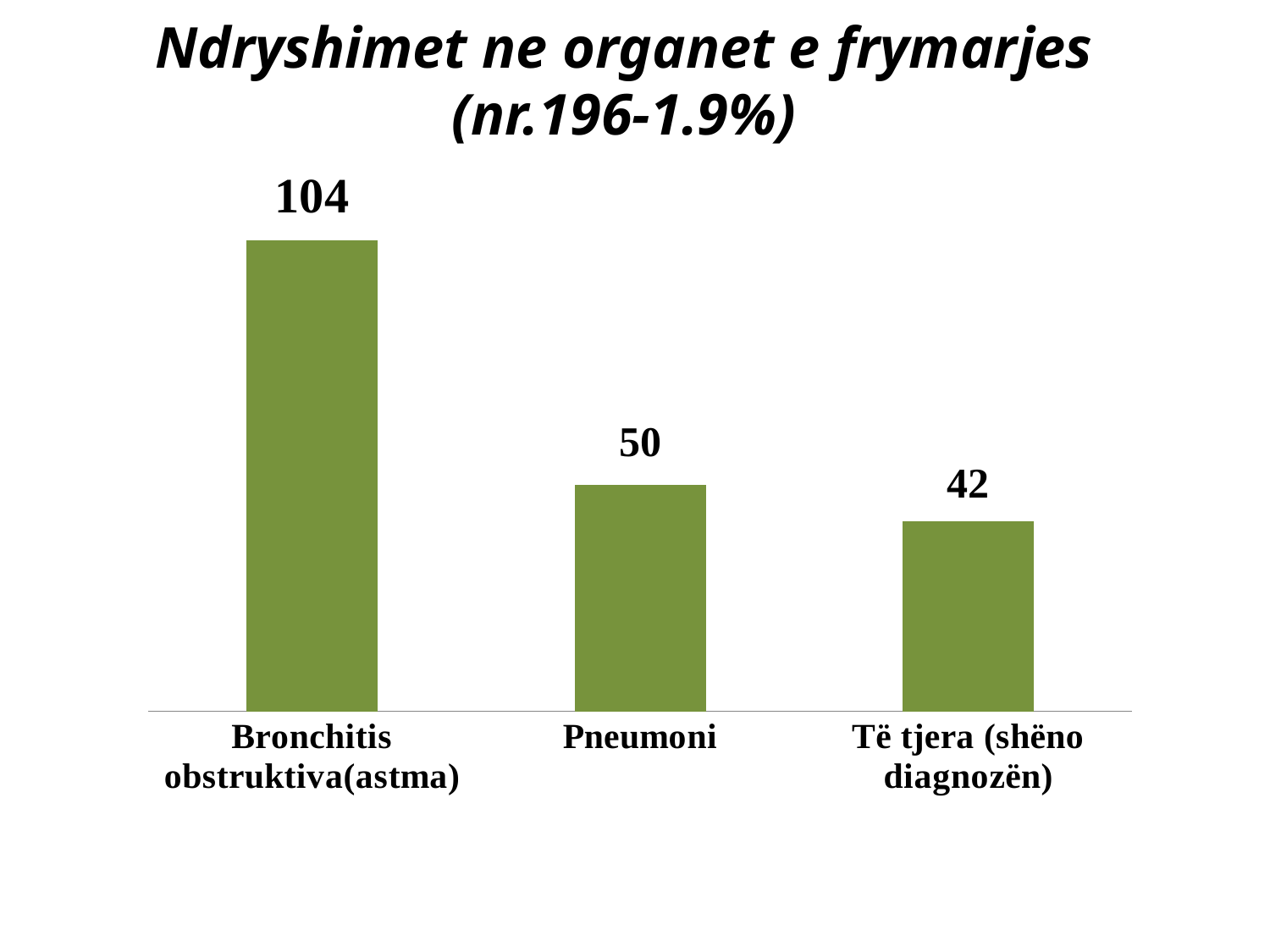
What is the difference between the values for Bronchitis obstruktiva(astma) and Pneumoni? 54 Which category has the lowest value? Të tjera (shëno diagnozën) What kind of chart is shown on the slide? Bar chart Do the values rise or fall from left to right across the categories? Fall What is the value for Bronchitis obstruktiva(astma)? 104 Which is larger, the value for Pneumoni or the value for Të tjera (shëno diagnozën)? Pneumoni What is the title of the slide? Ndryshimet ne organet e frymarjes (nr.196-1.9%) Which category has the highest value? Bronchitis obstruktiva(astma) What is the value for Të tjera (shëno diagnozën)? 42 What is the value for Pneumoni? 50 How many categories are shown in the chart? 3 What is the difference between the values for Pneumoni and Të tjera (shëno diagnozën)? 8